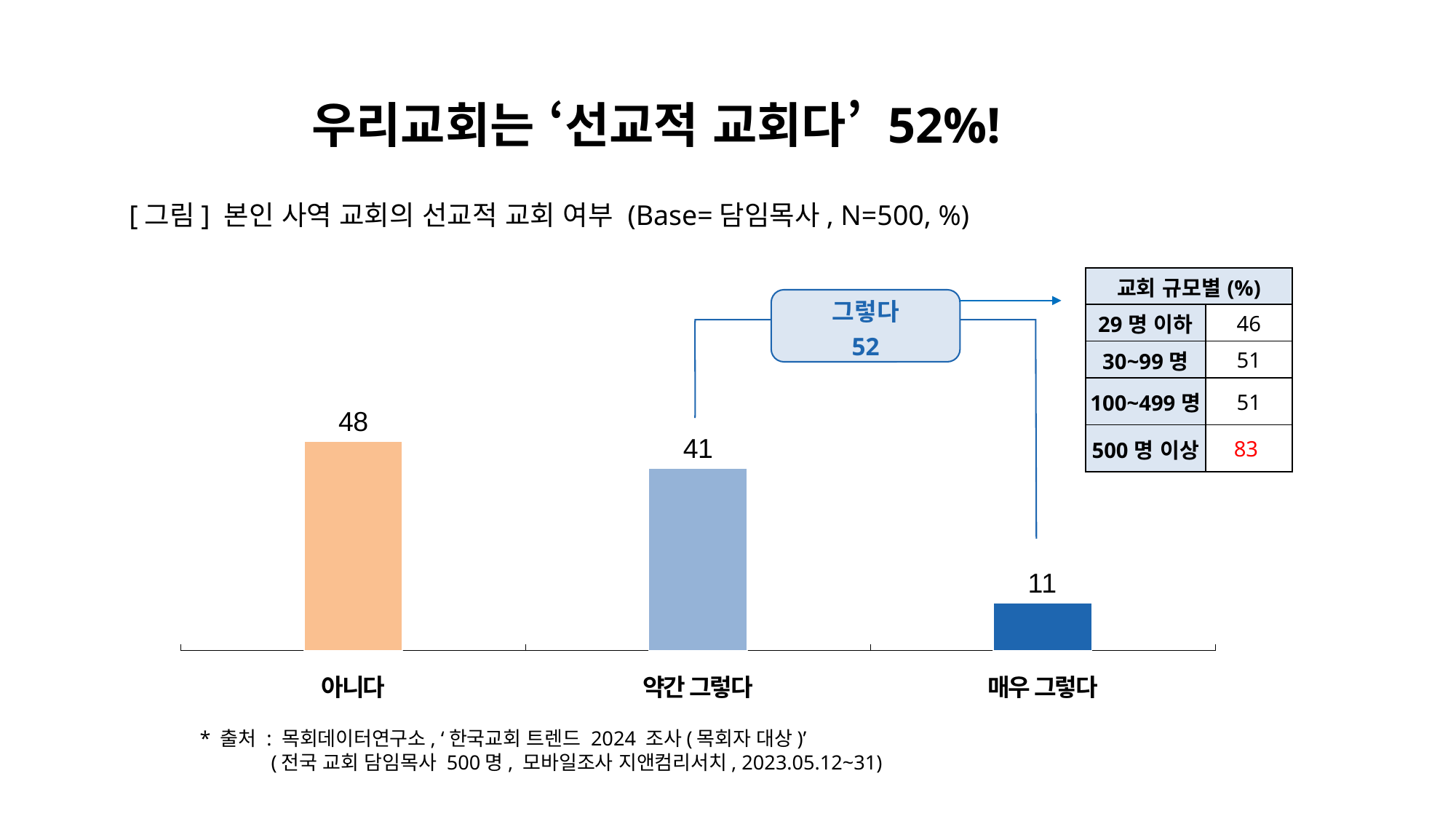
What kind of chart is shown on the slide? bar chart Which category has the highest value? 아니다 What is the difference between the values for 아니다 and 약간 그렇다? 7 What is the value for 아니다? 48 Do the values rise or fall from left to right across the categories? fall What is the value for 약간 그렇다? 41 Which is larger, the value for 아니다 or the value for 매우 그렇다? 아니다 Which category has the lowest value? 매우 그렇다 What is the value for 매우 그렇다? 11 How many categories are shown in the chart? 3 What is the difference between the values for 약간 그렇다 and 매우 그렇다? 30 What is the combined value labelled 그렇다 shown in the callout above the chart? 52